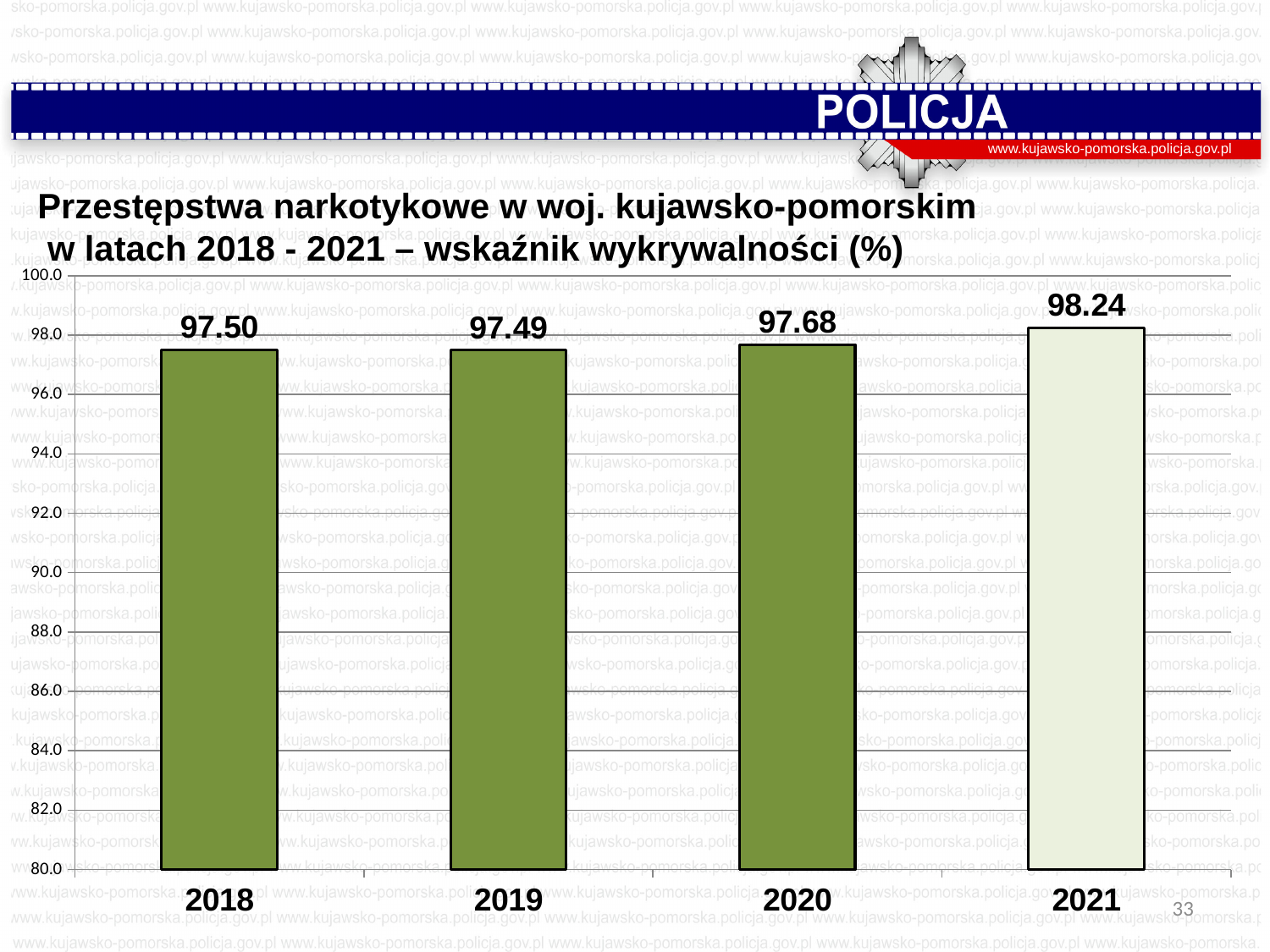
What is the value for 2019? 97.49 What is the value for 2018? 97.50 Which year has the highest value? 2021 What kind of chart is shown on the slide? bar chart Which bar is drawn in a different colour from the others? 2021 Is the value for 2021 greater or less than 98.0? greater What is the value for 2020? 97.68 Which is larger, the value for 2020 or the value for 2019? 2020 What is the difference between the values for 2021 and 2020? 0.56 Which year has the lowest value? 2019 How many years are shown on the x axis? 4 What is the value for 2021? 98.24